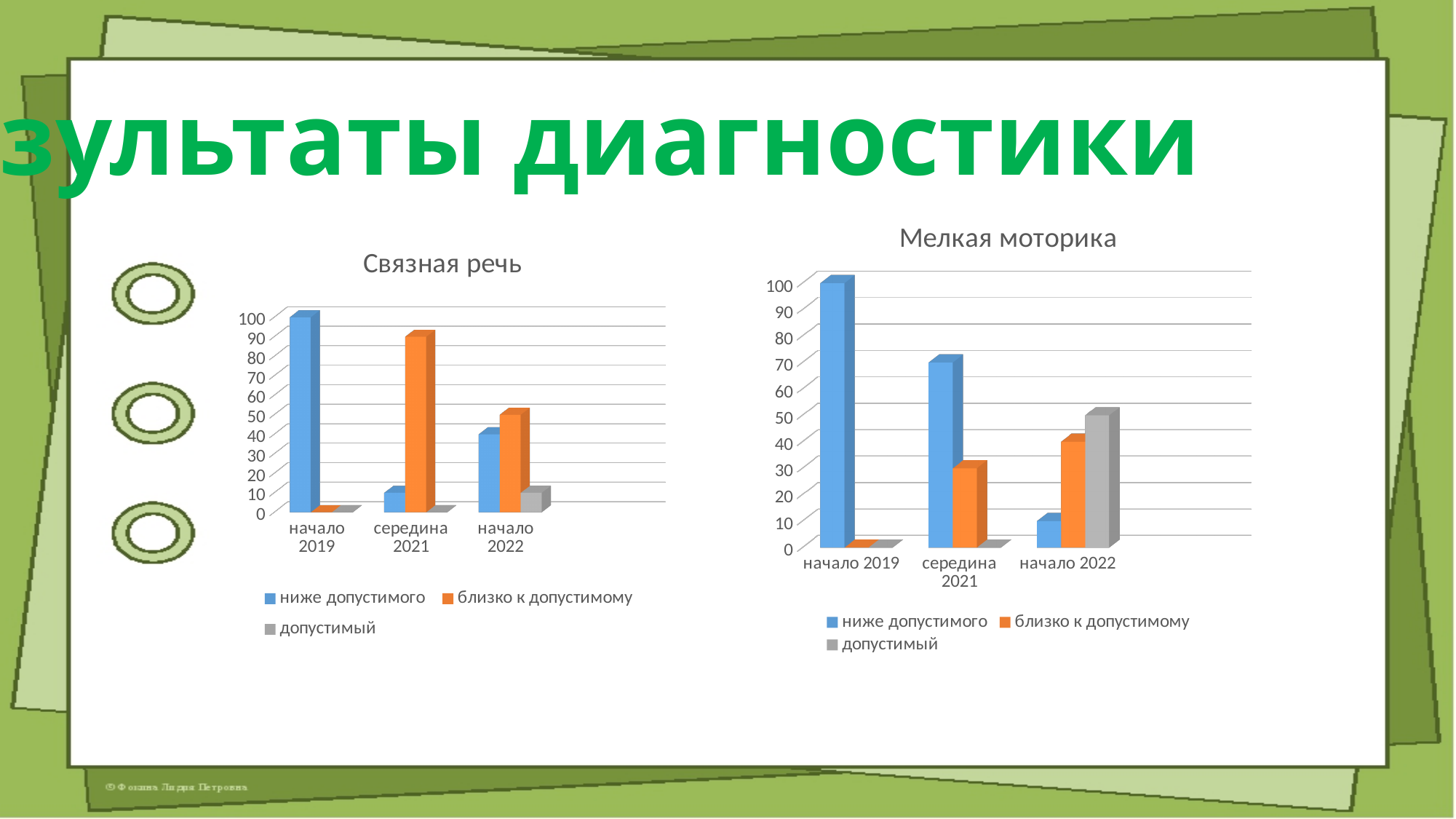
In the "Связная речь" chart, is the value for "близко к допустимому" at середина 2021 greater or less than 80? greater In the "Мелкая моторика" chart, is the value for "допустимый" at начало 2022 greater or less than 30? greater In the "Связная речь" chart, is the value for "ниже допустимого" at начало 2022 greater or less than 50? less What type of chart is the "Связная речь" chart? bar chart In the "Связная речь" chart, which category has the lowest value for "ниже допустимого"? середина 2021 How many categories are shown on the x axis of the "Связная речь" chart? 3 In the "Связная речь" chart, does the value for "ниже допустимого" rise or fall from начало 2019 to середина 2021? fall In the "Мелкая моторика" chart, which category has the highest value for "ниже допустимого"? начало 2019 How many series does the legend of the "Мелкая моторика" chart list? 3 In the "Мелкая моторика" chart, which is larger at начало 2022: "ниже допустимого" or "допустимый"? допустимый Which colour represents the "близко к допустимому" series in the "Мелкая моторика" chart? orange